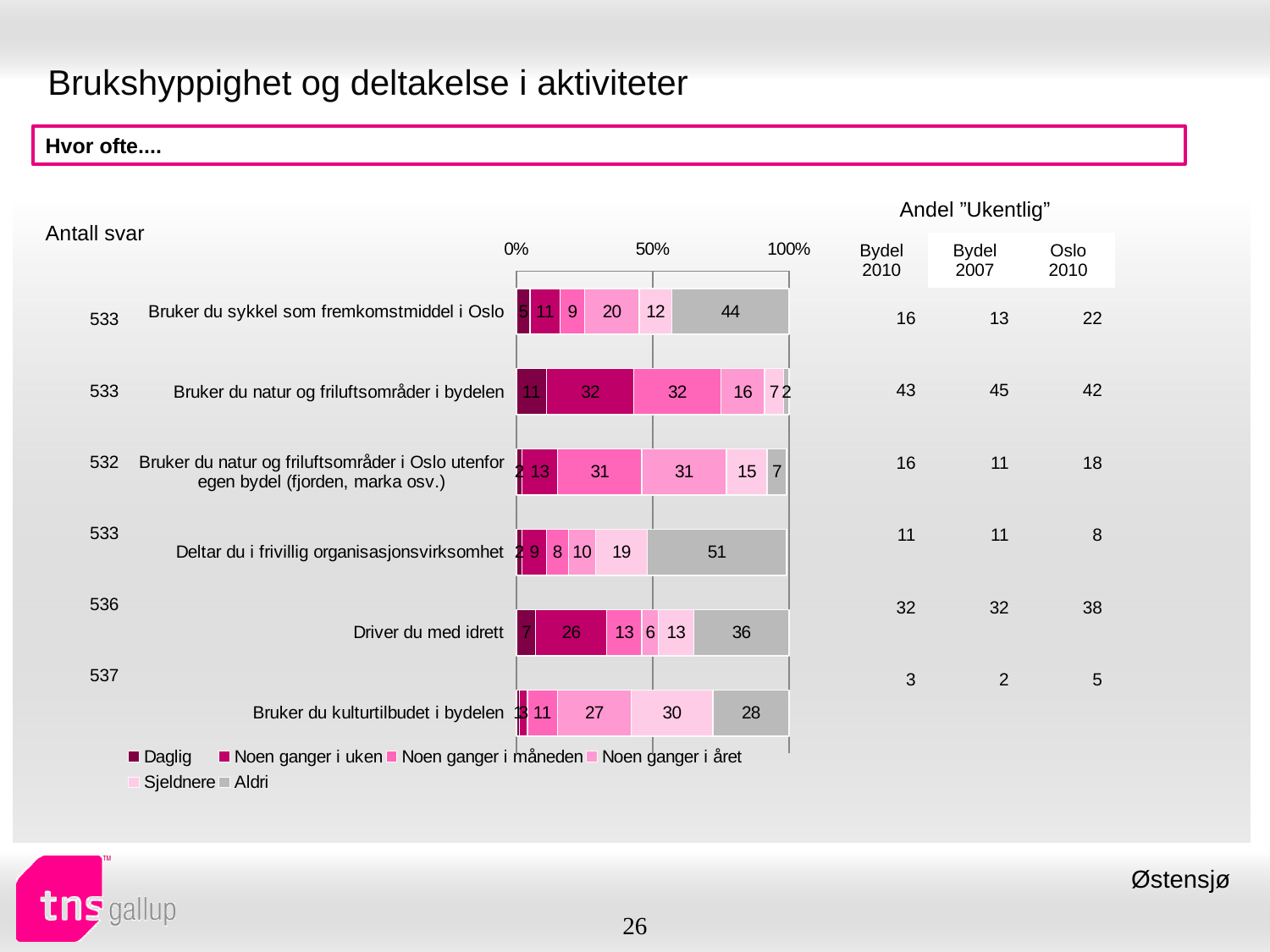
Which category has the highest value for "Aldri"? Deltar du i frivillig organisasjonsvirksomhet What is the value for "Sjeldnere" in the bar for "Bruker du kulturtilbudet i bydelen"? 30 Which category has the lowest value for "Aldri"? Bruker du natur og friluftsområder i bydelen What is the value for "Aldri" in the bar for "Deltar du i frivillig organisasjonsvirksomhet"? 51 Which has the larger "Noen ganger i uken" value: "Driver du med idrett" or "Bruker du sykkel som fremkomstmiddel i Oslo"? Driver du med idrett What kind of chart is shown on the slide? Stacked bar chart What is the value for "Noen ganger i uken" in the bar for "Driver du med idrett"? 26 What is the value for "Aldri" in the bar for "Bruker du sykkel som fremkomstmiddel i Oslo"? 44 What is the difference between the "Aldri" values for "Bruker du sykkel som fremkomstmiddel i Oslo" and "Driver du med idrett"? 8 How many series does the legend of the chart list? 6 What is the value for "Noen ganger i uken" in the bar for "Bruker du natur og friluftsområder i bydelen"? 32 How many categories (questions) are shown in the stacked bar chart? 6